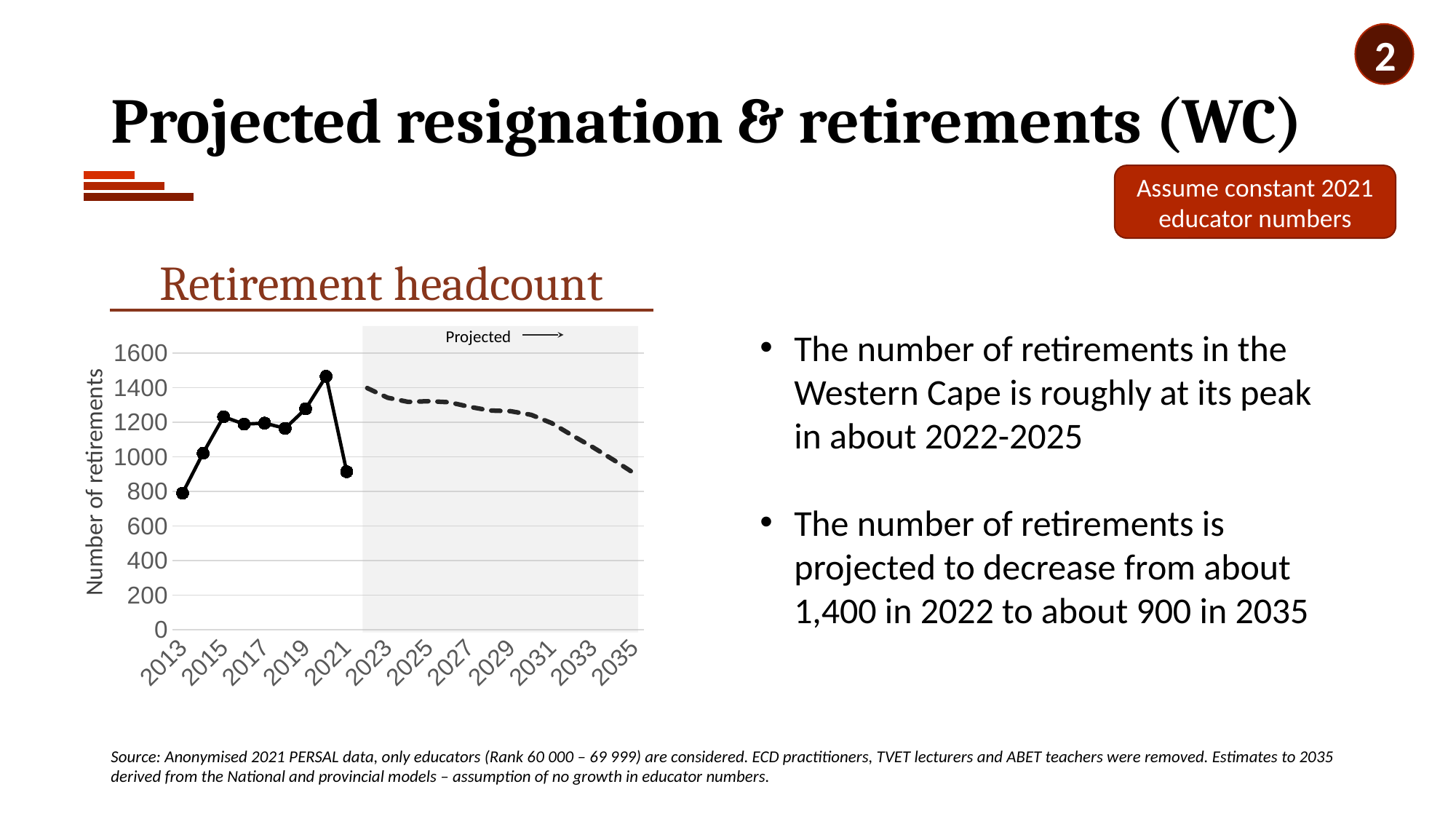
In the Retirement headcount chart, which year has the larger number of retirements, 2020 or 2021? 2020 In the Retirement headcount chart, which year has the highest number of retirements among the solid-line (actual) data points? 2020 In the Retirement headcount chart, do the projected values rise or fall from 2023 to 2035? fall In the Retirement headcount chart, which year has the larger number of retirements, 2013 or 2014? 2014 What kind of chart is the Retirement headcount chart? line chart How many solid-line (actual) data points are plotted in the Retirement headcount chart? 9 In the Retirement headcount chart, is the value for 2013 greater or less than 1000? less In the Retirement headcount chart, is the projected value for 2035 greater or less than 1000? less In the Retirement headcount chart, which year has the lowest number of retirements among the solid-line (actual) data points? 2013 In the Retirement headcount chart, is the value for 2021 greater or less than 1000? less What is the y-axis title of the Retirement headcount chart? Number of retirements